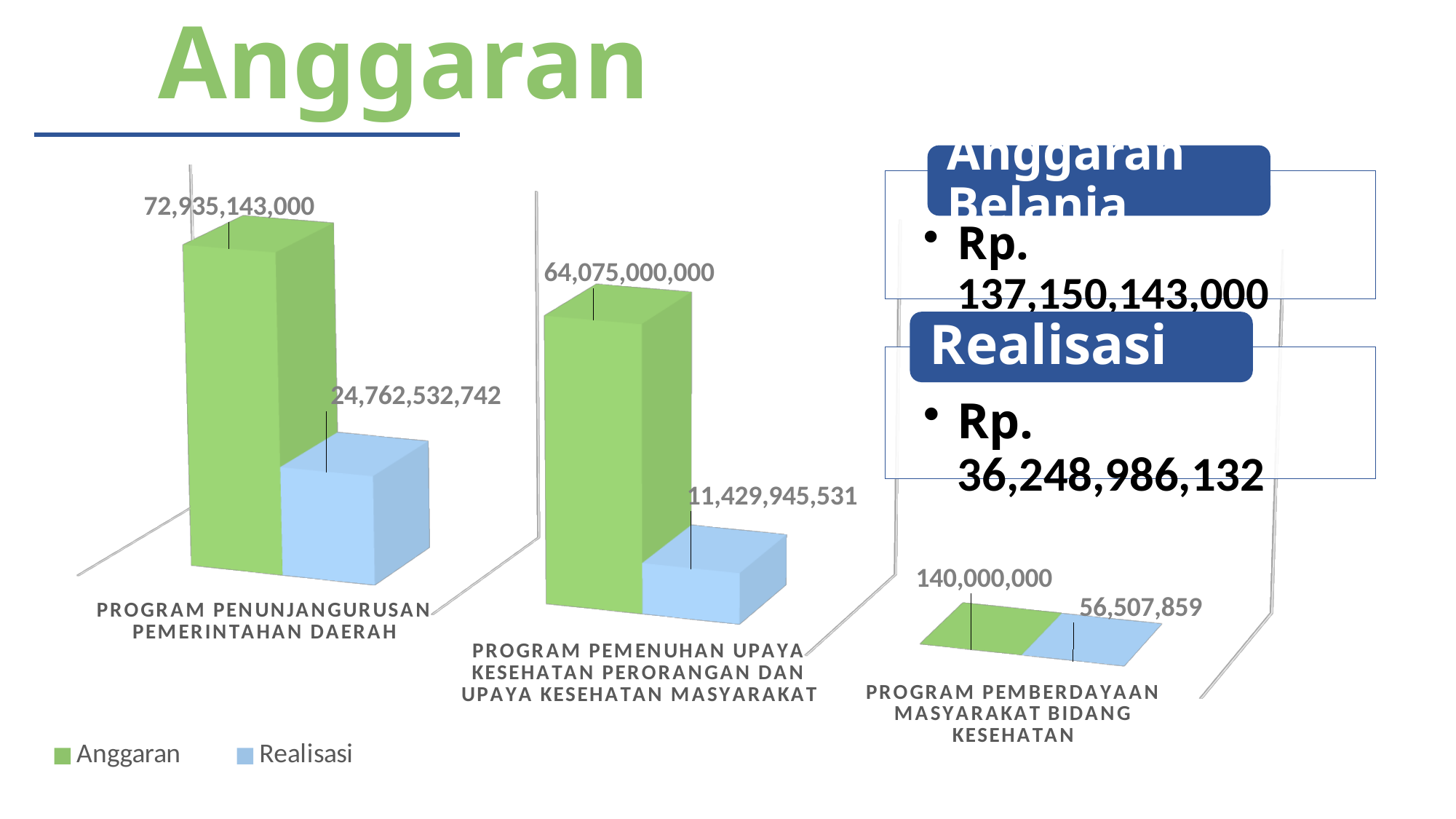
Which program has the lowest Realisasi value? Program Pemberdayaan Masyarakat Bidang Kesehatan How many program categories are shown in the chart? 3 What is the Realisasi value for Program Pemberdayaan Masyarakat Bidang Kesehatan? 56,507,859 How many series does the chart legend list? 2 What is the difference between Anggaran and Realisasi for Program Pemberdayaan Masyarakat Bidang Kesehatan? 83,492,141 Which program has the highest Anggaran value? Program Penunjangurusan Pemerintahan Daerah Which is larger: the Realisasi for Program Penunjangurusan Pemerintahan Daerah or the Realisasi for Program Pemenuhan Upaya Kesehatan Perorangan dan Upaya Kesehatan Masyarakat? Program Penunjangurusan Pemerintahan Daerah What type of chart is shown on the slide? Bar chart What is the difference between Anggaran and Realisasi for Program Penunjangurusan Pemerintahan Daerah? 48,172,610,258 What is the Realisasi value for Program Penunjangurusan Pemerintahan Daerah? 24,762,532,742 What is the Anggaran value for Program Pemenuhan Upaya Kesehatan Perorangan dan Upaya Kesehatan Masyarakat? 64,075,000,000 What is the Anggaran value for Program Penunjangurusan Pemerintahan Daerah? 72,935,143,000